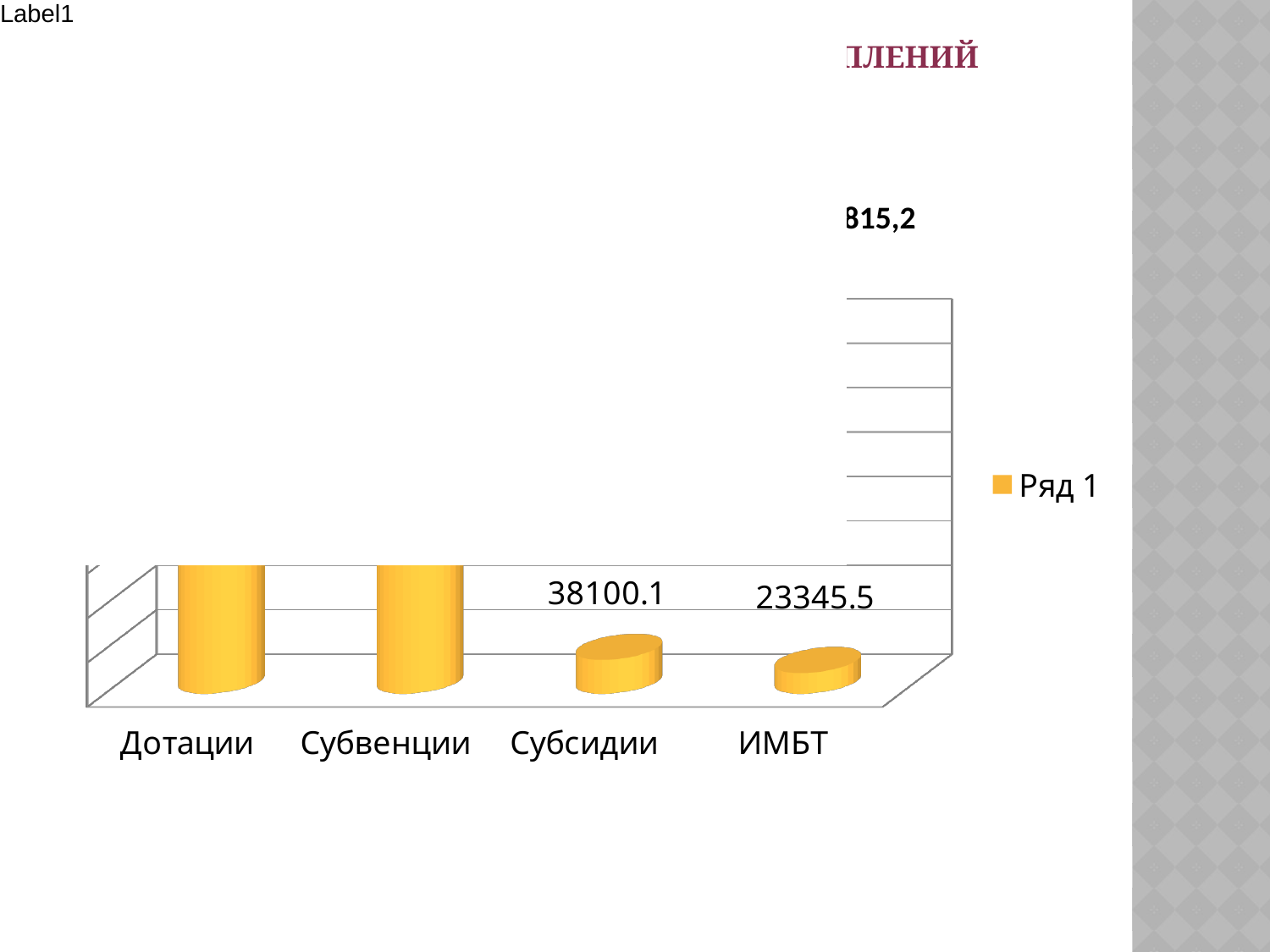
Which category has the lowest value? ИМБТ Which is larger, the value for Субвенции or the value for ИМБТ? Субвенции How many categories are shown on the x axis? 4 What is the value for ИМБТ? 23345.5 What kind of chart is shown on the slide? Bar chart What colour are the bars in the chart? Yellow What is the name of the series in the legend? Ряд 1 What is the value for Субсидии? 38100.1 What is the difference between the values for Субсидии and ИМБТ? 14754.6 Which is larger, the value for Субсидии or the value for ИМБТ? Субсидии How many series does the legend list? 1